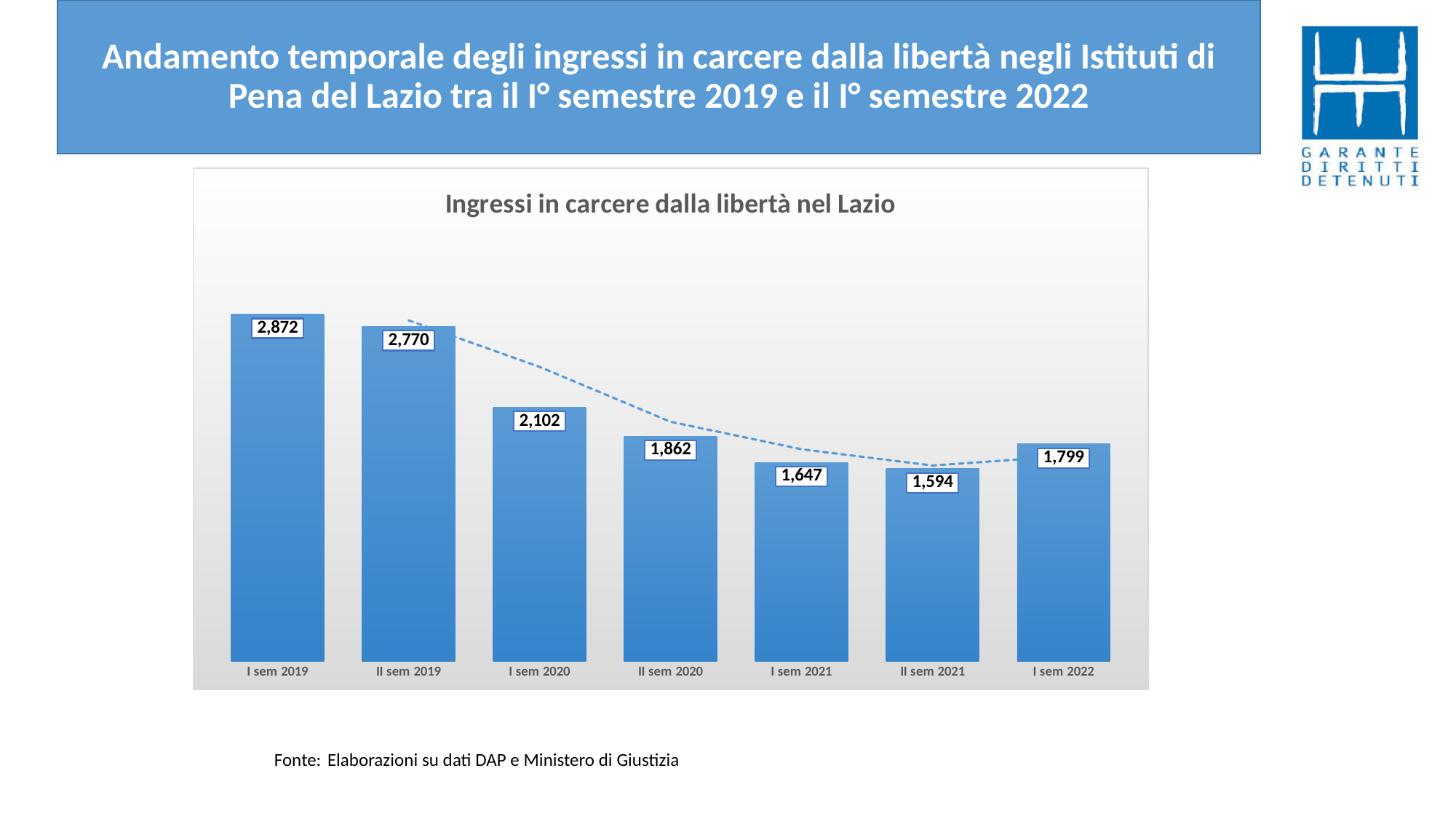
Which semester has the highest value? I sem 2019 What is the value for II sem 2021? 1,594 Which is larger, the value for II sem 2020 or the value for I sem 2021? II sem 2020 Which semester has the lowest value? II sem 2021 What is the value for I sem 2019? 2,872 What is the difference between the values for I sem 2019 and II sem 2019? 102 What is the difference between the values for I sem 2022 and II sem 2021? 205 What is the title of the chart? Ingressi in carcere dalla libertà nel Lazio What is the value for I sem 2022? 1,799 What is the value for I sem 2020? 2,102 What kind of chart is shown on the slide? Bar chart How many semesters are shown on the x axis? 7